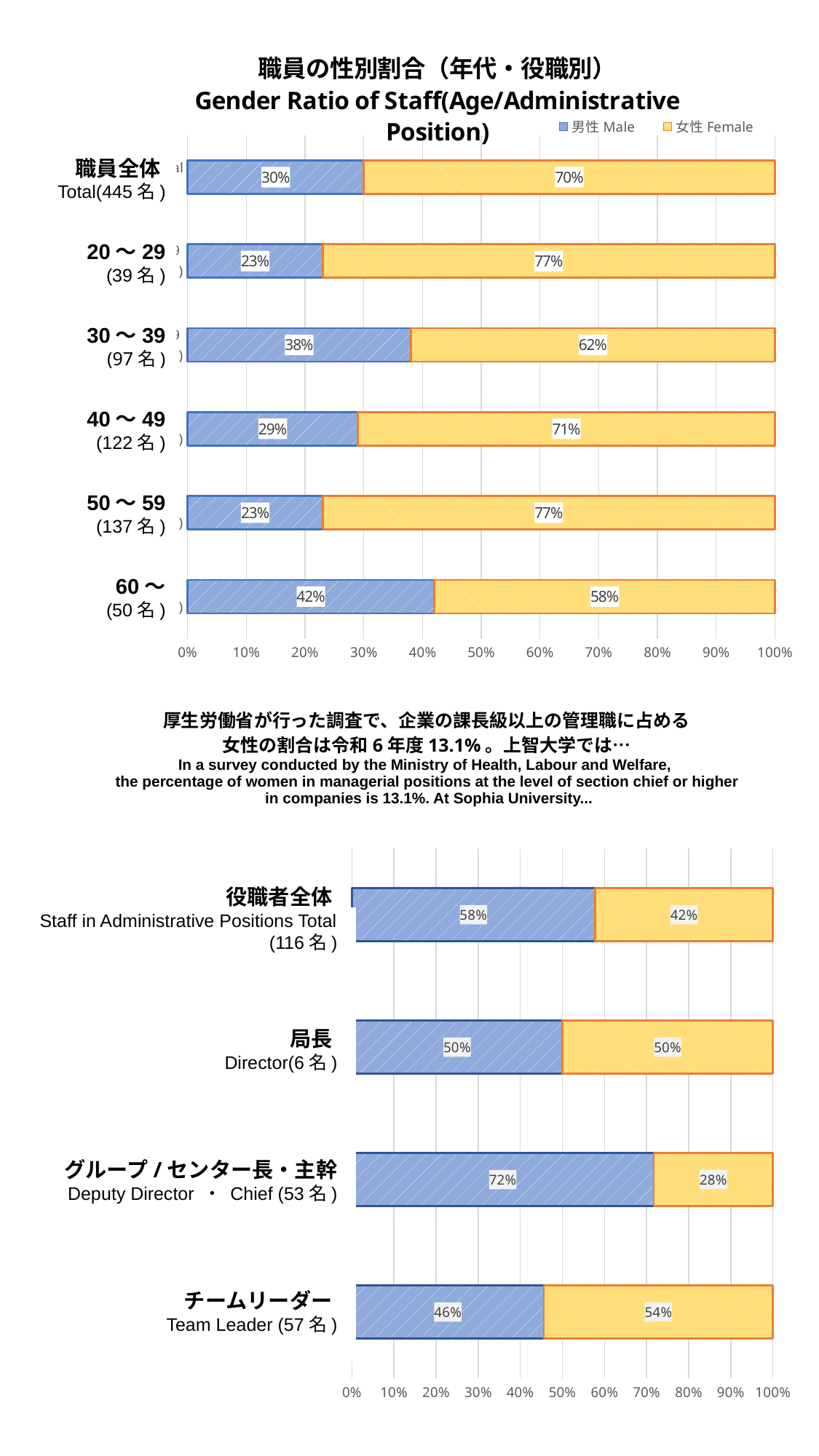
In the bottom chart (administrative positions), what is the difference between the Male and Female percentages for Deputy Director・Chief? 44% In the top chart (Gender Ratio of Staff by age), how many categories (bars) are shown? 6 What kind of chart is the top chart (Gender Ratio of Staff by age)? Stacked bar chart In the top chart (Gender Ratio of Staff by age), which age group has the lowest Female percentage? 60～ In the top chart (Gender Ratio of Staff by age), what is the Female percentage for the 50～59 age group? 77% In the top chart (Gender Ratio of Staff by age), what is the difference between the Female and Male percentages for the Total (445名) row? 40% In the bottom chart (administrative positions), is the Male percentage for Staff in Administrative Positions Total larger or smaller than the Male percentage for Team Leader? larger In the bottom chart (administrative positions), what is the Male percentage for Deputy Director・Chief (53名)? 72% In the top chart (Gender Ratio of Staff by age), what is the Male percentage for the 30～39 age group? 38% In the top chart (Gender Ratio of Staff by age), how many series does the legend list? 2 In the bottom chart (administrative positions), which position has the highest Female percentage? Team Leader In the top chart (Gender Ratio of Staff by age), which age group has the highest Male percentage? 60～